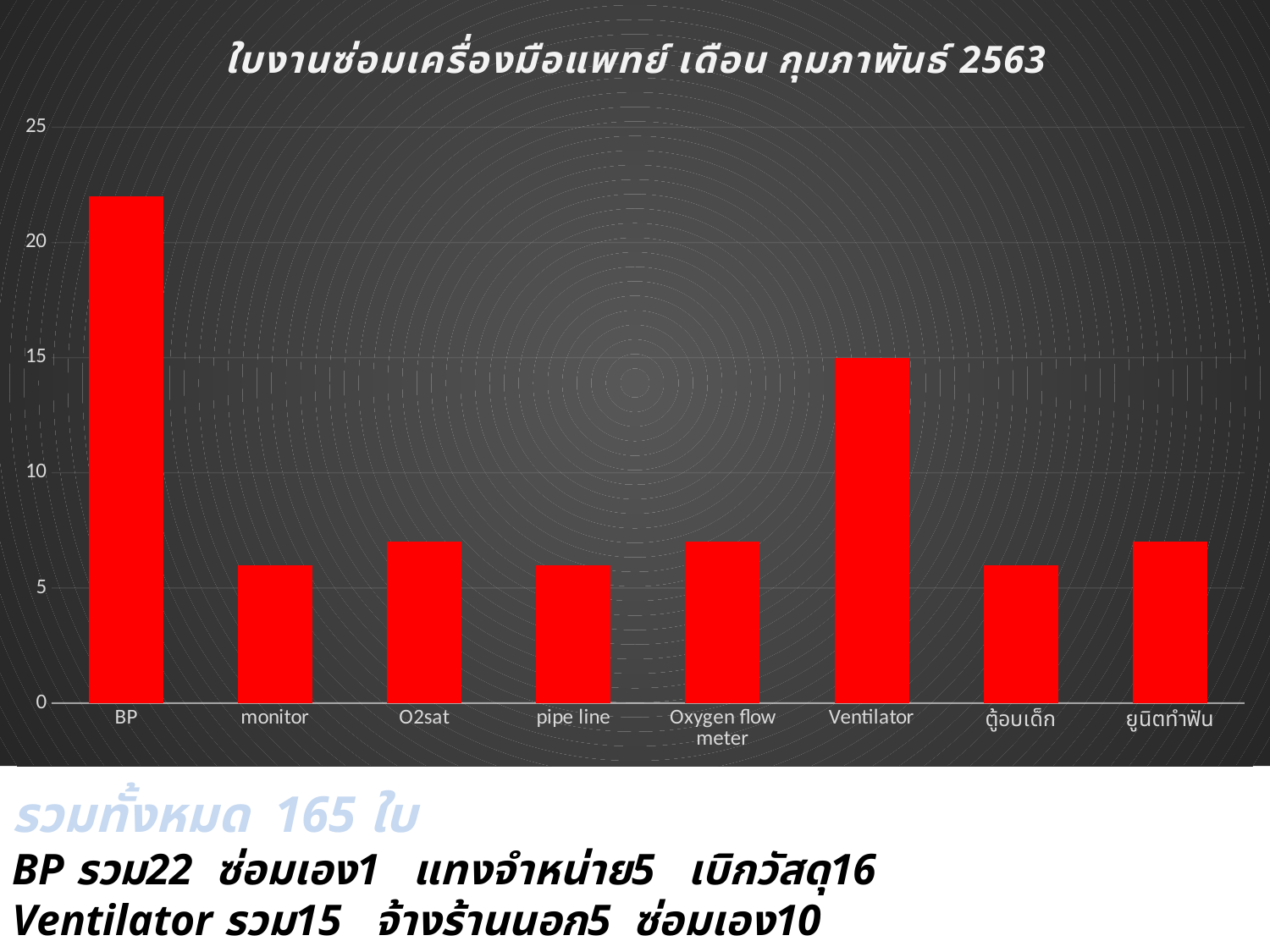
What is the title of the chart? ใบงานซ่อมเครื่องมือแพทย์ เดือน กุมภาพันธ์ 2563 What is the difference between the values for BP and Ventilator? 7 Which category has the highest bar in the chart? BP What type of chart is shown on the slide? Bar chart What colour are the bars in the chart? Red Which is larger, the value for Ventilator or the value for monitor? Ventilator What is the value for Ventilator in the chart? 15 Which is larger, the value for BP or the value for Ventilator? BP What is the value for BP in the chart? 22 Is the value for monitor greater or less than 10? less Is the value for BP greater or less than 20? greater How many categories are shown on the x axis of the chart? 8